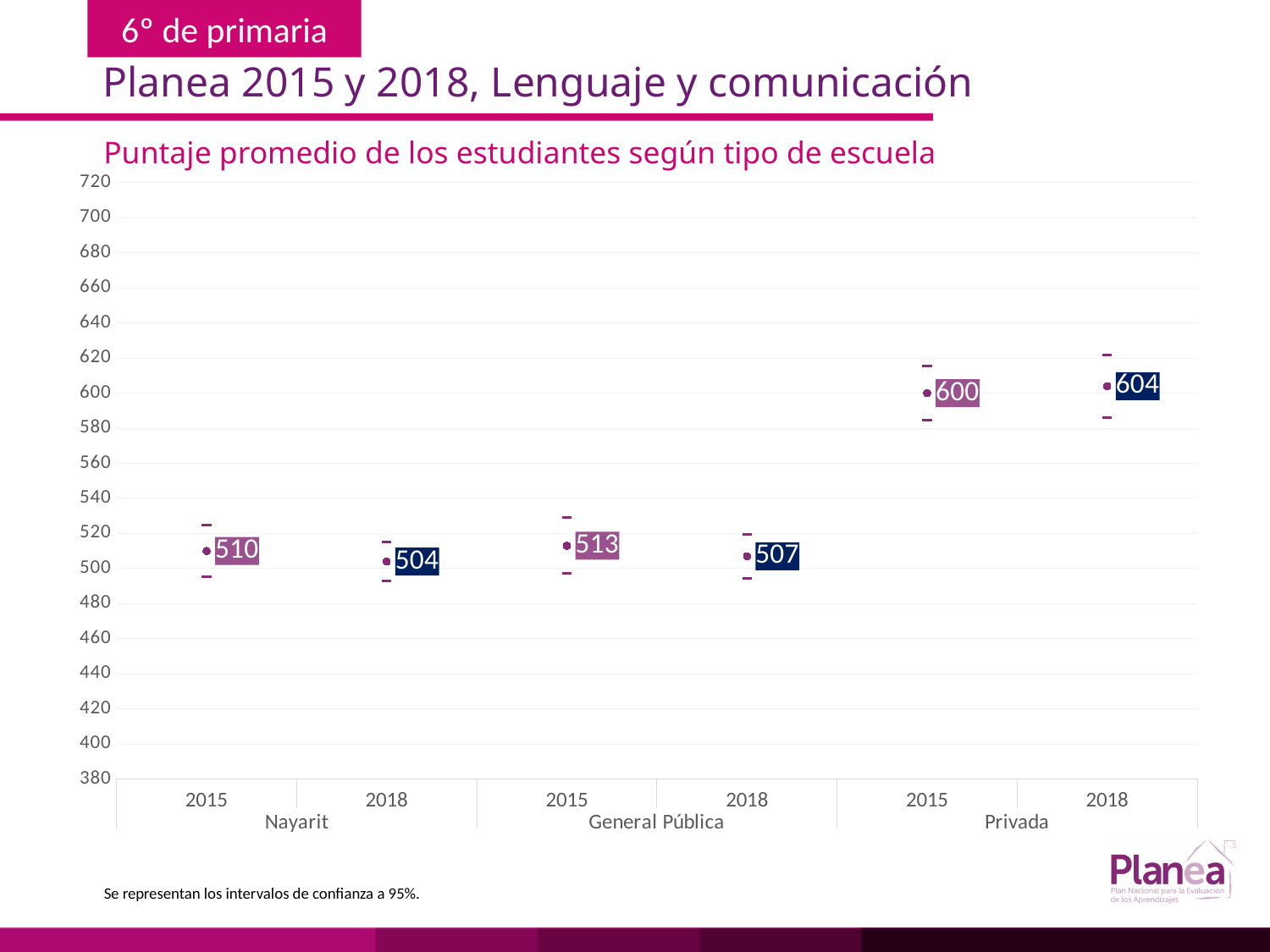
Which group and year has the lowest average score? Nayarit 2018 What is the average score for General Pública schools in 2015? 513 Did the Nayarit average score rise or fall from 2015 to 2018? fall What is the difference between the Privada scores in 2018 and 2015? 4 What is the average score for Nayarit in 2015? 510 How many data points are plotted on the chart? 6 What is the difference between the General Pública score in 2015 and the Nayarit score in 2015? 3 What is the title of the chart? Puntaje promedio de los estudiantes según tipo de escuela What is the average score for Privada schools in 2018? 604 Which is larger, the General Pública score in 2018 or the Nayarit score in 2018? General Pública 2018 What is the average score for Nayarit in 2018? 504 Which group and year has the highest average score? Privada 2018